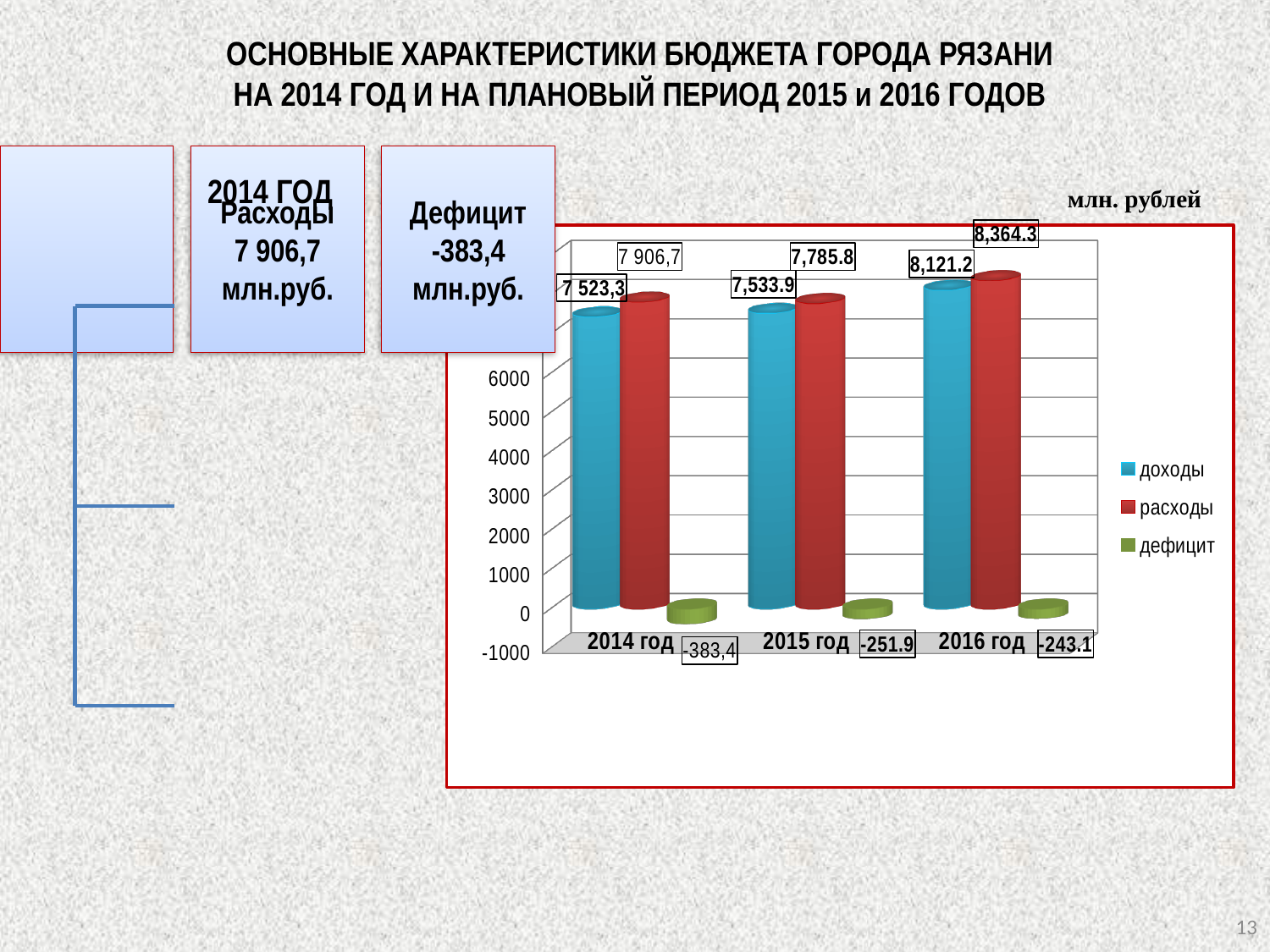
What is the difference between расходы and доходы for 2016 год? 243.1 What kind of chart is shown? bar chart How many series does the legend list? 3 Do the доходы values rise or fall from 2014 год to 2016 год? rise What is the value of расходы for 2015 год? 7,785.8 In which year is доходы the highest? 2016 год What is the value of расходы for 2016 год? 8,364.3 What is the value of дефицит for 2015 год? -251.9 How many years are shown on the x axis? 3 In which year is расходы the lowest? 2015 год What is the value of доходы for 2014 год? 7 523,3 Which is larger for 2015 год: доходы or расходы? расходы